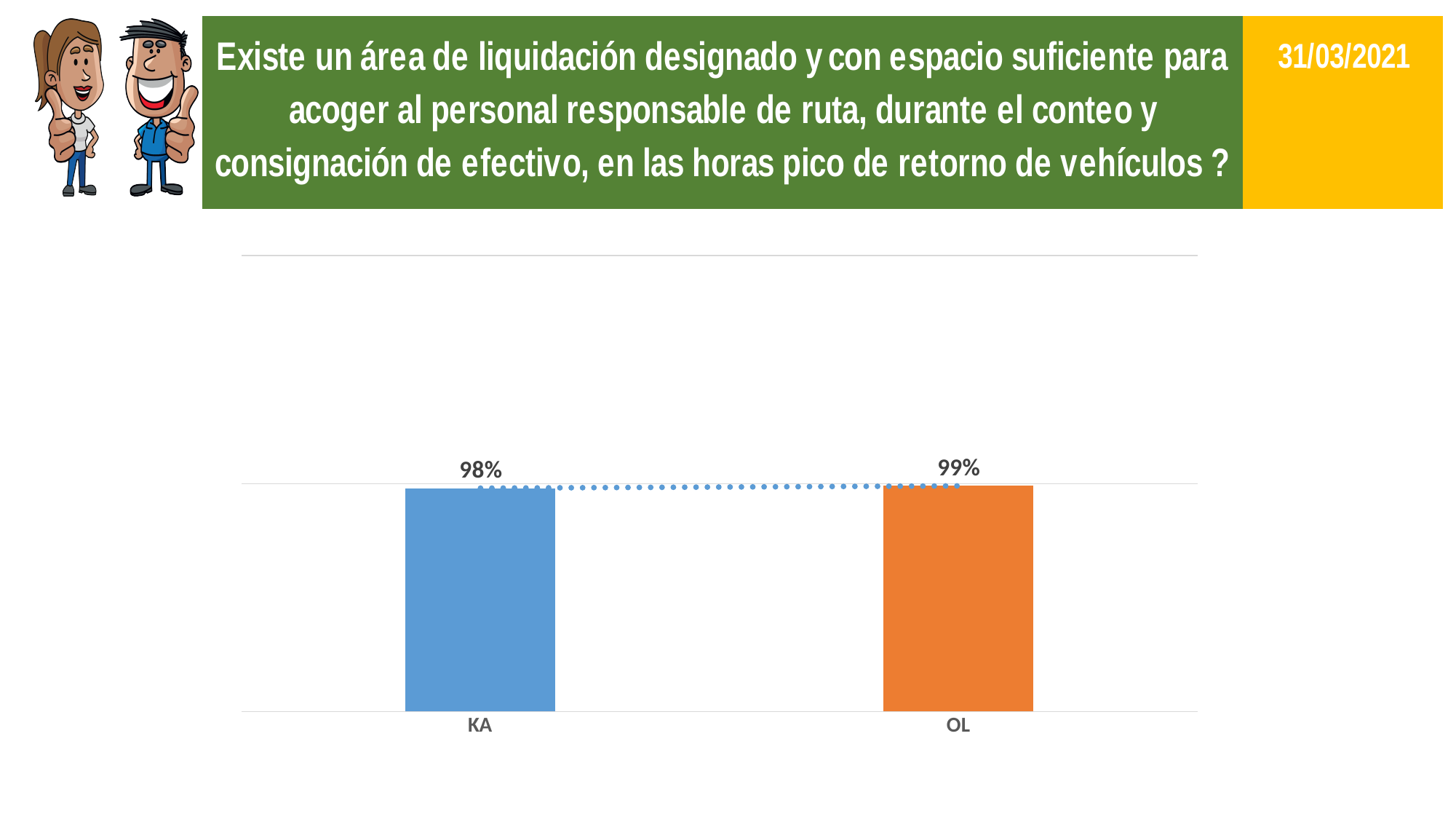
Which category has the highest value? OL Which is larger, the value for KA or the value for OL? OL What is the difference between the values for OL and KA? 1% How many categories are shown in the chart? 2 What kind of chart is shown on the slide? Bar chart Do the values rise or fall from KA to OL? Rise What is the value for KA? 98% What is the value for OL? 99% What colour is the bar for KA? Blue What colour is the bar for OL? Orange Which category has the lowest value? KA